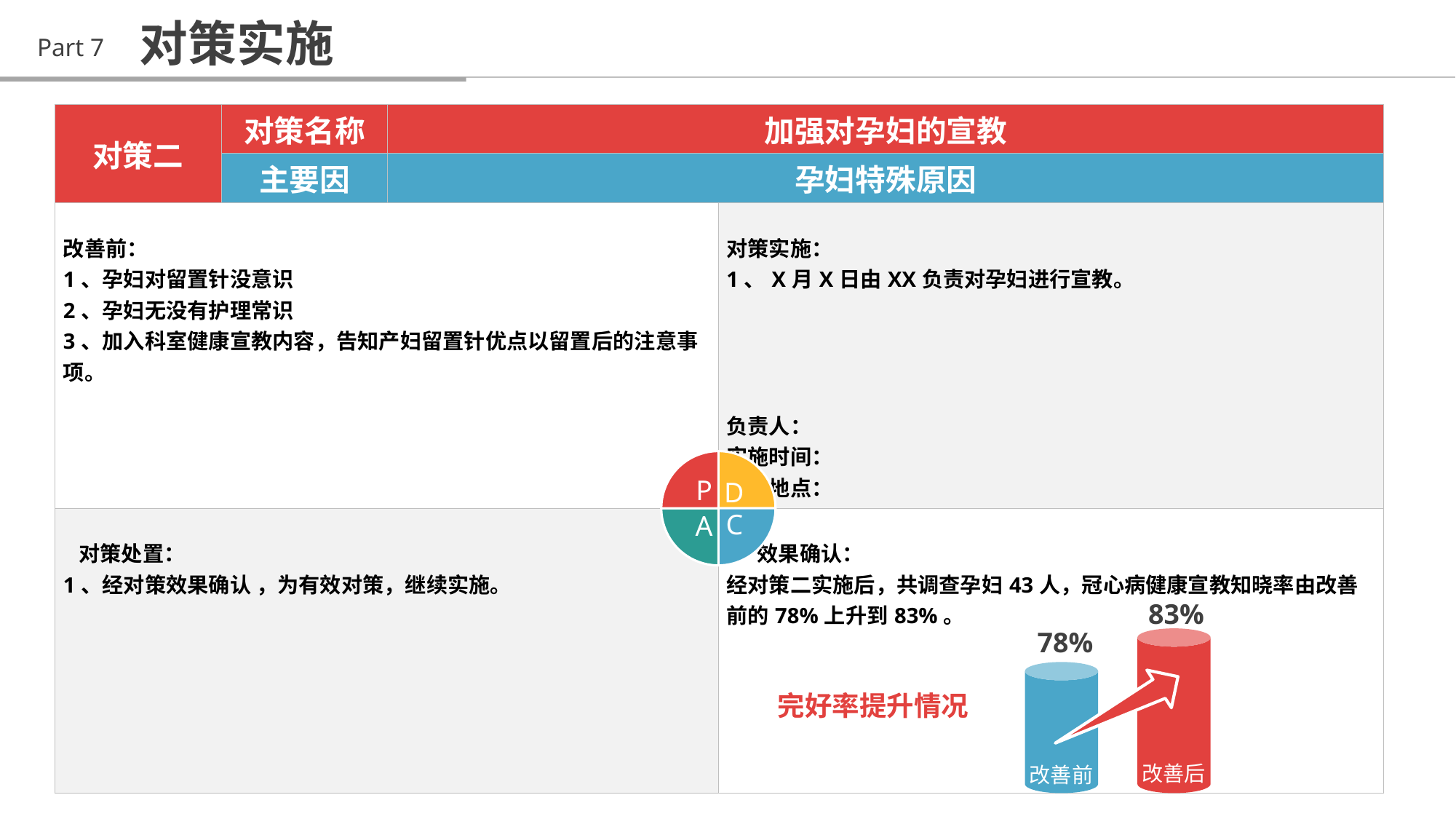
Which category has the lowest value in the chart? 改善前 What is the value for 改善前 in the chart? 78% What is the title of the chart on the slide? 完好率提升情况 What colour is the bar for 改善后 in the chart? red What is the difference between the values for 改善后 and 改善前 in the chart? 5% How many categories are shown in the chart? 2 Which category has the highest value in the chart? 改善后 Do the values rise or fall from 改善前 to 改善后 in the chart? rise What is the value for 改善后 in the chart? 83% Which category has the higher value in the chart, 改善前 or 改善后? 改善后